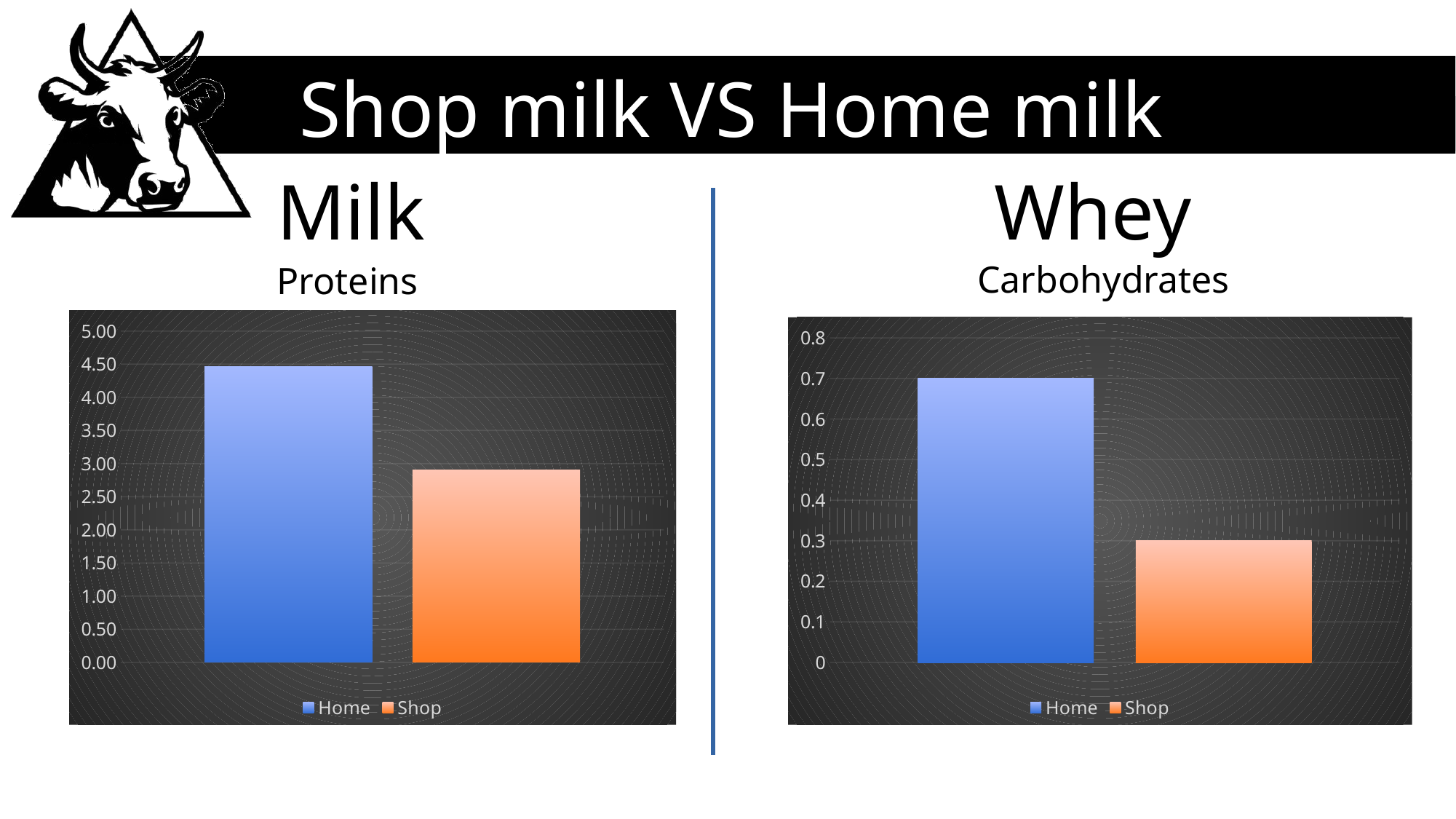
In the Proteins chart, is the value for Home greater or less than 4.00? greater In the Proteins chart, which series has the lower value? Shop In the Carbohydrates chart, which series has the higher value? Home What kind of chart is the Carbohydrates chart? bar chart In the Carbohydrates chart, what is the difference between the Home and Shop values? 0.4 How many series does the legend of the Proteins chart list? 2 In the Proteins chart, is the Home value larger or smaller than the Shop value? larger In the Proteins chart, what colour is the Shop bar? orange What are the legend entries in the Carbohydrates chart? Home, Shop In the Carbohydrates chart, what is the value for Home? 0.7 In the Carbohydrates chart, what is the value for Shop? 0.3